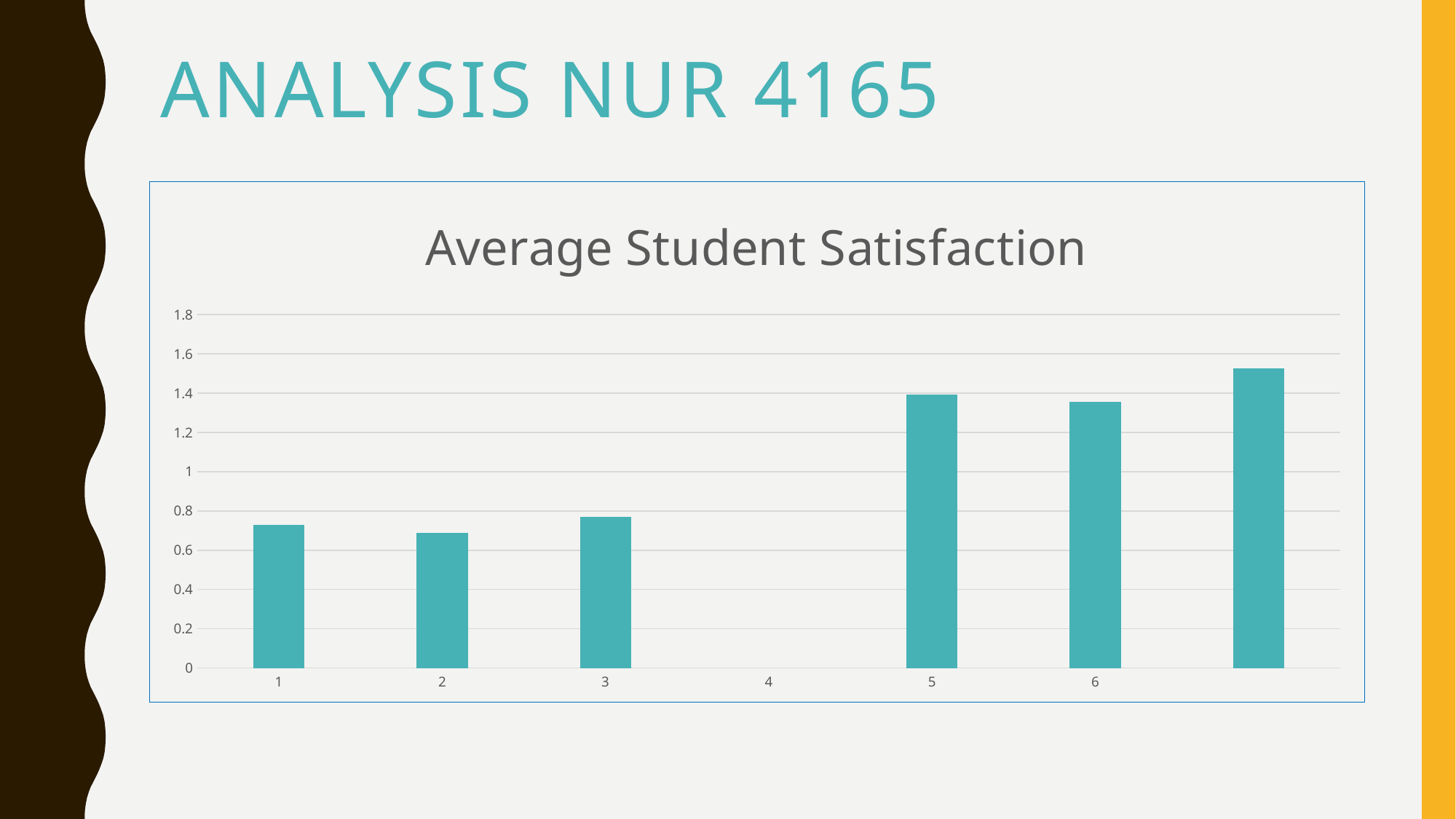
Which is larger, the value for category 1 or the value for category 6? category 6 Which is larger, the value for category 2 or the value for category 3? category 3 Is the value for category 5 greater or less than 1.2? greater What kind of chart is shown on the slide? bar chart Is the value for category 6 greater or less than 1.4? less Is the value for category 3 greater or less than 0.8? less What is the title of the chart? Average Student Satisfaction Which labelled category on the x axis has no bar drawn? 4 Which is larger, the value for category 3 or the value for category 5? category 5 How many category labels are shown on the x axis? 6